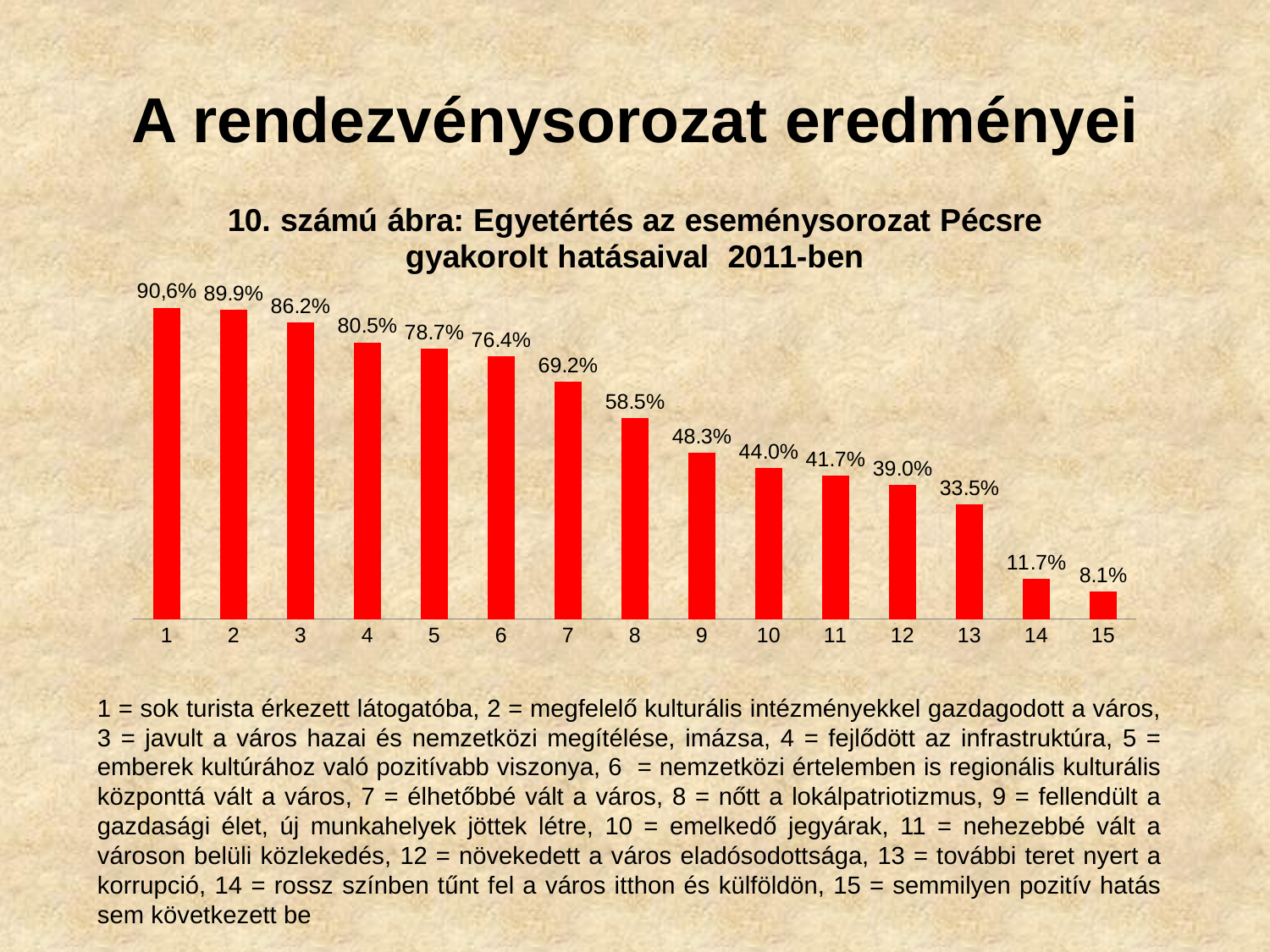
What is the value for category 13? 33.5% Do the values rise or fall from category 1 to category 15? fall What kind of chart is shown on the slide? bar chart What is the value for category 8? 58.5% What is the value for category 4? 80.5% Which category has the highest value? 1 Which category has the lowest value? 15 Which is larger, the value for category 9 or the value for category 10? category 9 What is the value for category 1? 90,6% What is the difference between the values for category 7 and category 8? 10.7% How many categories are shown on the x axis? 15 What is the difference between the values for category 14 and category 15? 3.6%